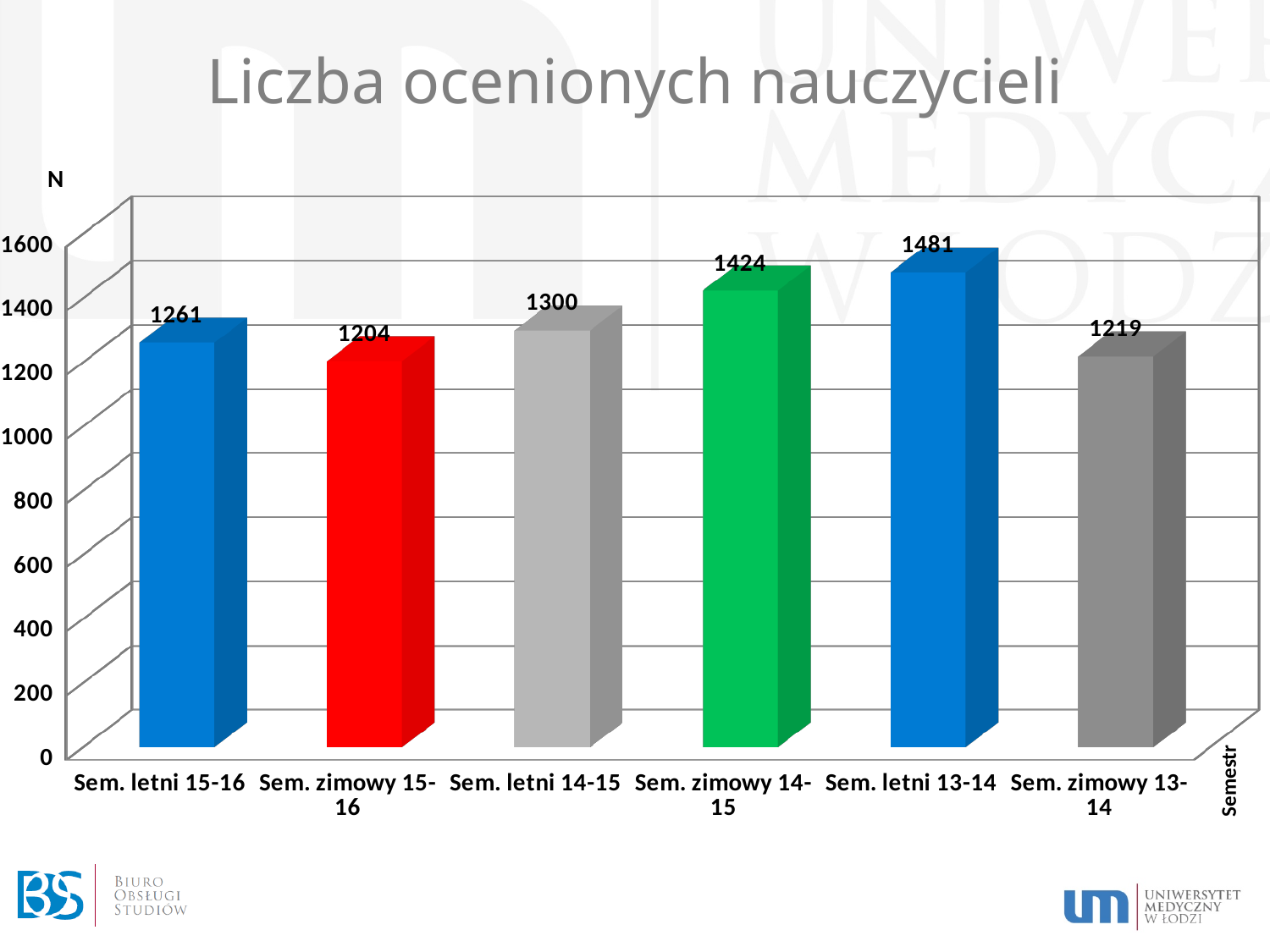
What is the value for Sem. zimowy 13-14? 1219 What is the value for Sem. letni 15-16? 1261 What is the difference between the values for Sem. letni 14-15 and Sem. letni 15-16? 39 Which semester has the lowest number of evaluated teachers? Sem. zimowy 15-16 What is the difference between the values for Sem. letni 13-14 and Sem. zimowy 15-16? 277 What is the value for Sem. zimowy 14-15? 1424 Is the value for Sem. letni 13-14 greater or less than 1400? greater Which semester has the highest number of evaluated teachers? Sem. letni 13-14 Which is larger, the value for Sem. zimowy 14-15 or the value for Sem. letni 14-15? Sem. zimowy 14-15 How many semesters are shown on the chart? 6 What is the title of the chart? Liczba ocenionych nauczycieli What kind of chart is shown on the slide? bar chart